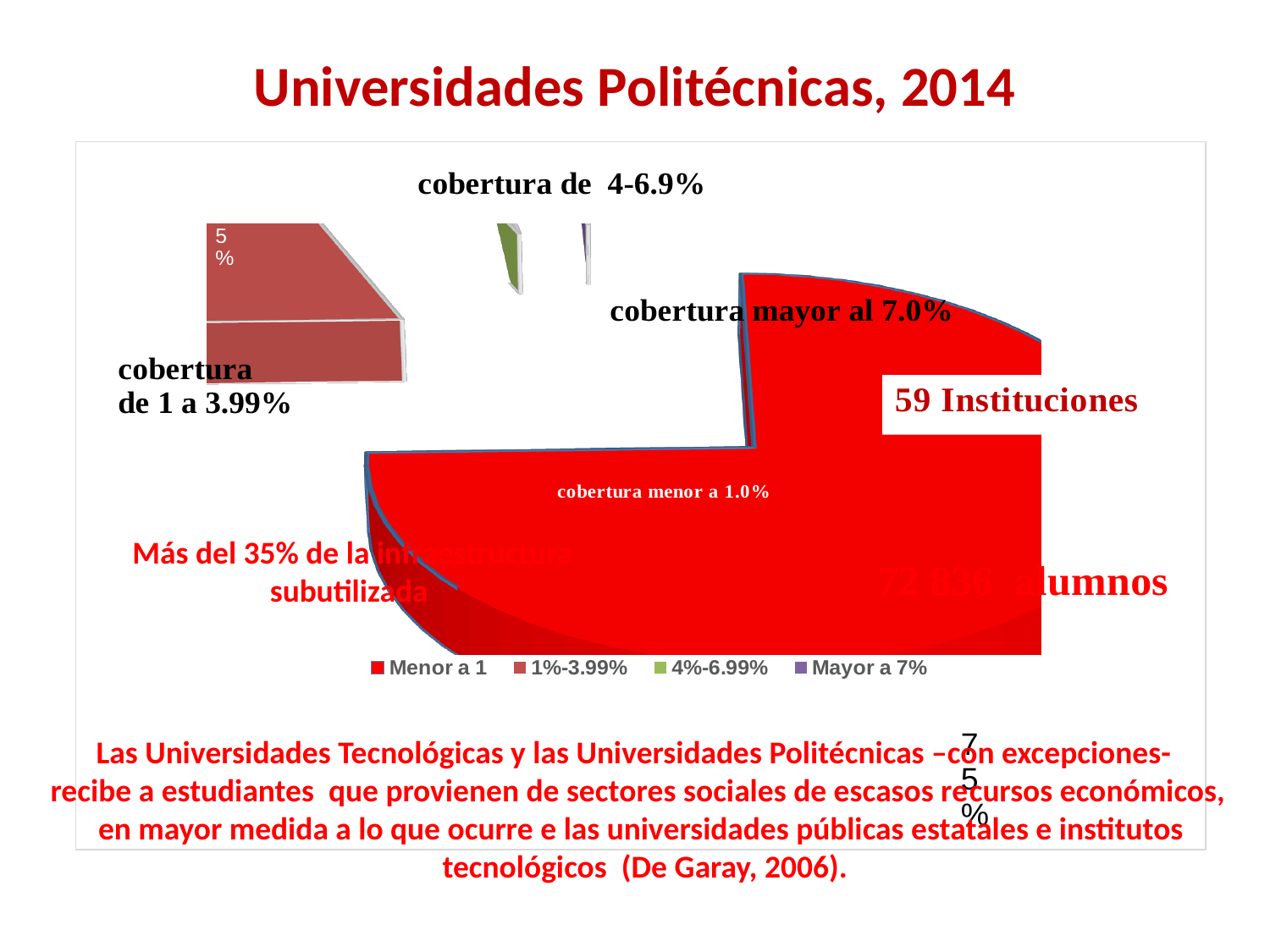
What percentage is shown for the Menor a 1 slice? 75% How many slices does the pie chart have? 4 What is the title of the slide containing the pie chart? Universidades Politécnicas, 2014 Which category has the largest slice in the pie chart? Menor a 1 Which slice is larger, Menor a 1 or 1%-3.99%? Menor a 1 How many categories does the legend of the pie chart list? 4 Which slice is larger, 1%-3.99% or 4%-6.99%? 1%-3.99% Is the share of the Menor a 1 slice greater or less than 50%? greater What colour is used for the Menor a 1 category in the legend? red Is the share of the 1%-3.99% slice greater or less than 50%? less What kind of chart is shown on the slide? pie chart